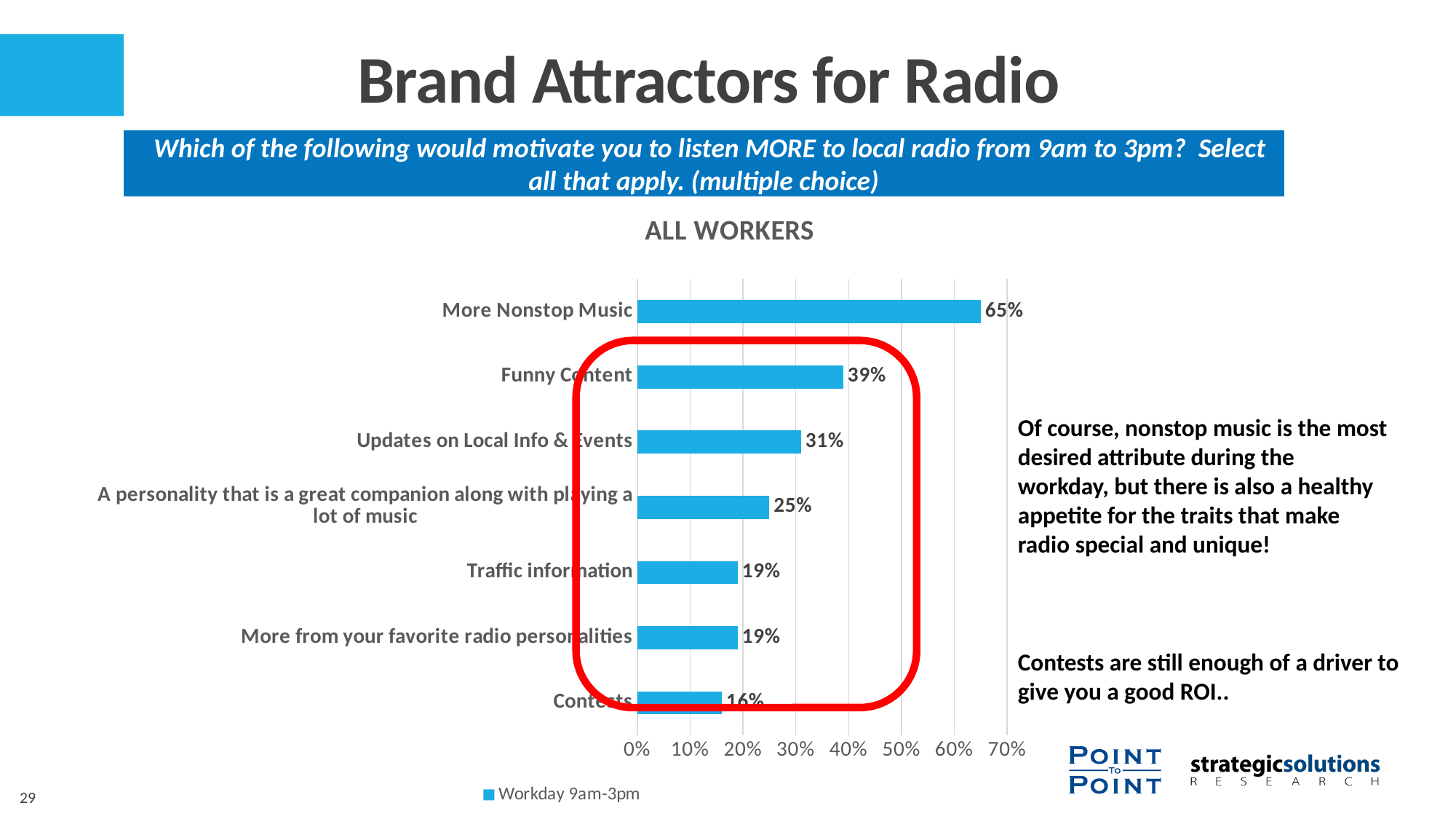
Which category has the highest value? More Nonstop Music What is the value for Funny Content? 39% What series name does the legend show? Workday 9am-3pm How many categories are shown in the chart? 7 What is the difference between the values for More Nonstop Music and Funny Content? 26% What is the value for More Nonstop Music? 65% Is the value for A personality that is a great companion along with playing a lot of music greater or less than 30%? less What kind of chart is shown on the slide? Bar chart What is the value for Contests? 16% Which category has the lowest value? Contests What is the value for Updates on Local Info & Events? 31% Which is larger, the value for Updates on Local Info & Events or the value for Traffic information? Updates on Local Info & Events